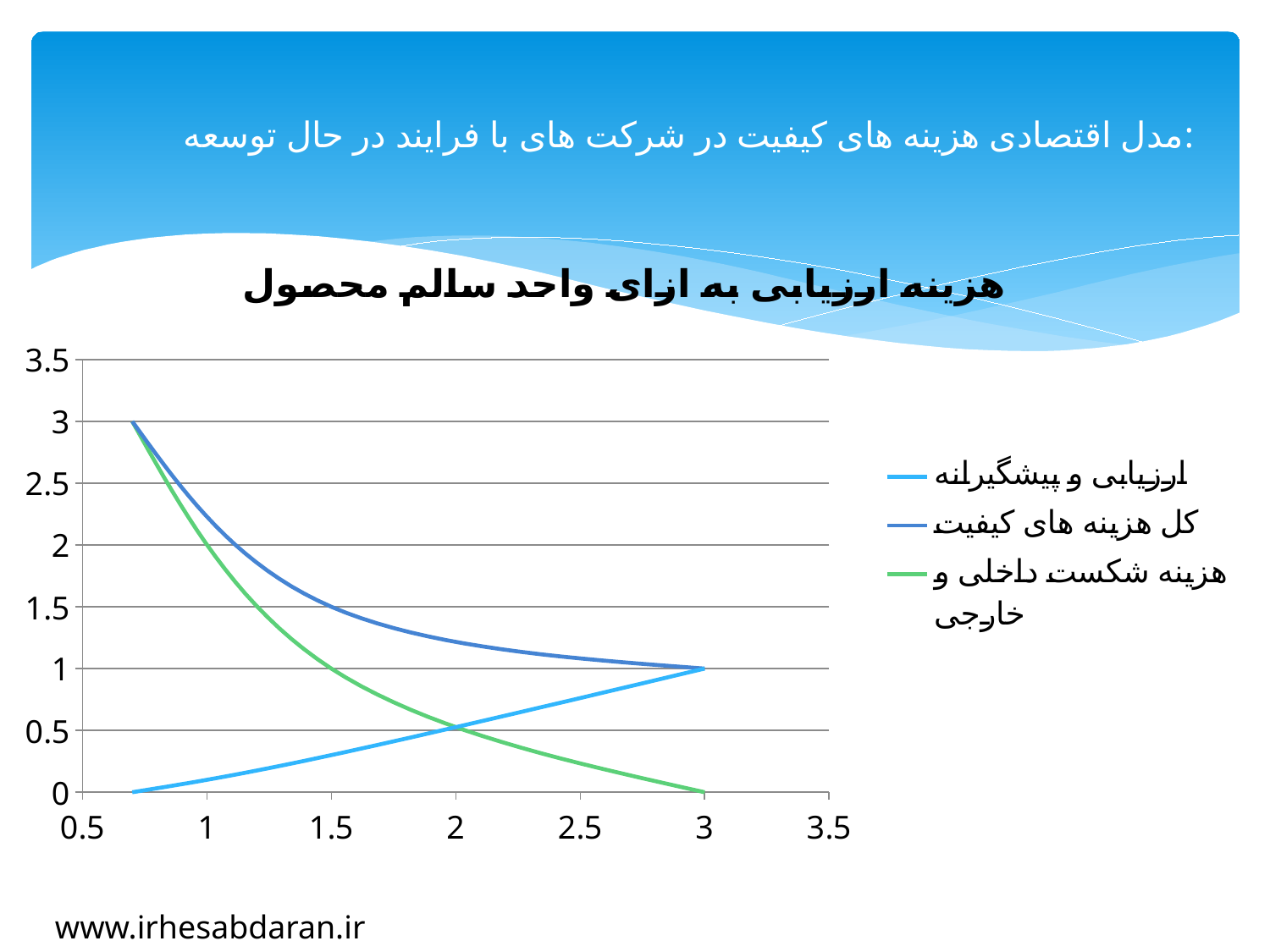
How many series does the legend list? 3 Does the series 'ارزیابی و پیشگیرانه' rise or fall as x increases? rise What is the value of the series 'هزینه شکست داخلی و خارجی' at x = 3? 0 Is the value of 'هزینه شکست داخلی و خارجی' at x = 2.5 greater or less than 0.5? less Does the series 'هزینه شکست داخلی و خارجی' rise or fall as x increases? fall What is the title of the chart? هزینه ارزیابی به ازای واحد سالم محصول What is the value of the series 'ارزیابی و پیشگیرانه' at x = 3? 1 What kind of chart is shown on the slide? line chart Is the value of 'کل هزینه های کیفیت' at x = 1 greater or less than 2? greater Does the series 'کل هزینه های کیفیت' rise or fall as x increases? fall At x = 2.5, which series has the higher value: 'ارزیابی و پیشگیرانه' or 'هزینه شکست داخلی و خارجی'? ارزیابی و پیشگیرانه Is the value of 'ارزیابی و پیشگیرانه' at x = 1 greater or less than 0.5? less